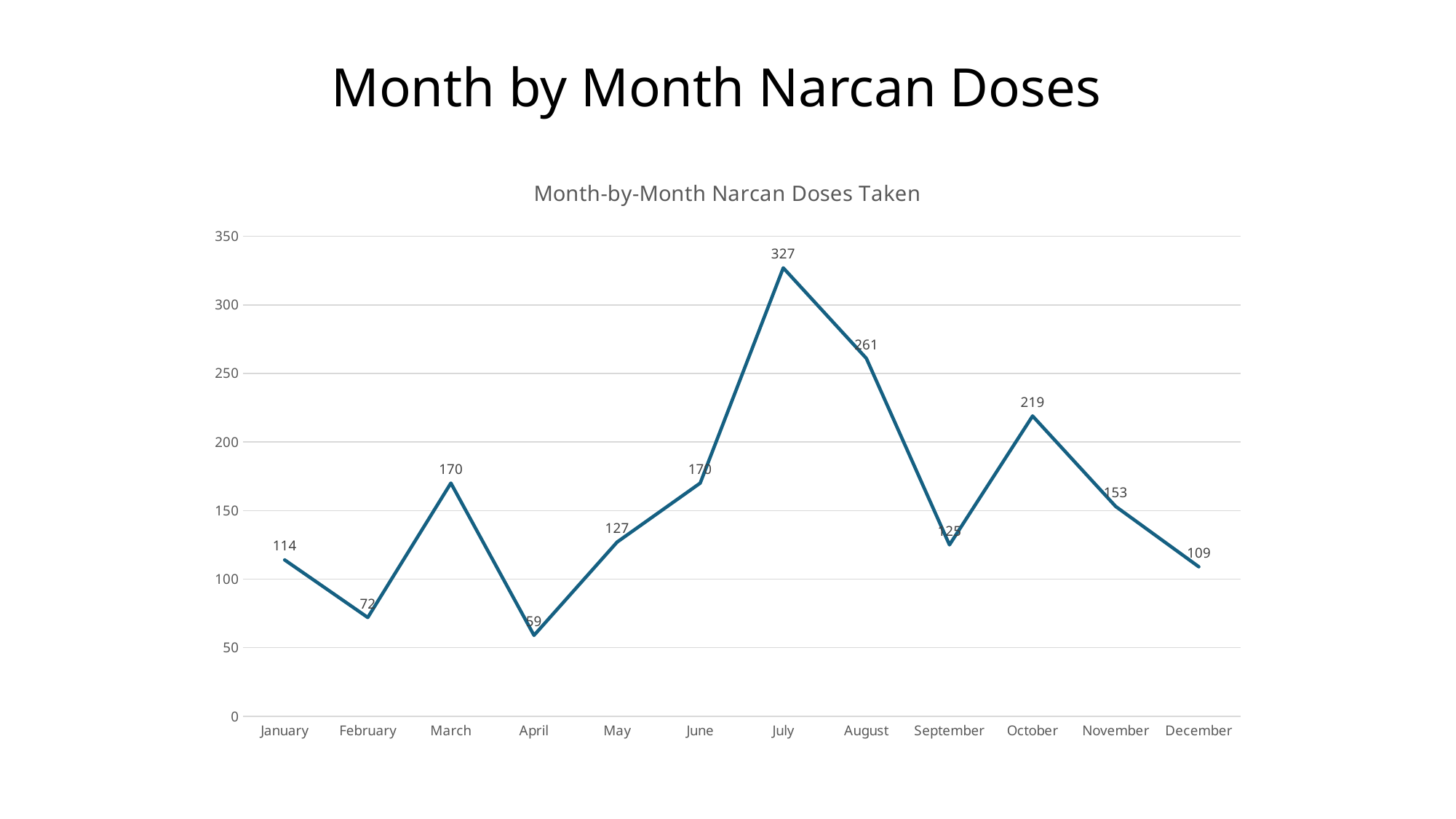
What type of chart is shown on the slide? line chart What is the value for October? 219 Which is larger, the value for November or the value for December? November What is the value for July? 327 Which month has the lowest value? April Which month has the highest value? July How many months are plotted on the x axis? 12 Do the values rise or fall from July to September? fall What is the value for April? 59 What is the title of the chart? Month-by-Month Narcan Doses Taken What is the difference between the values for July and August? 66 What is the difference between the values for March and February? 98